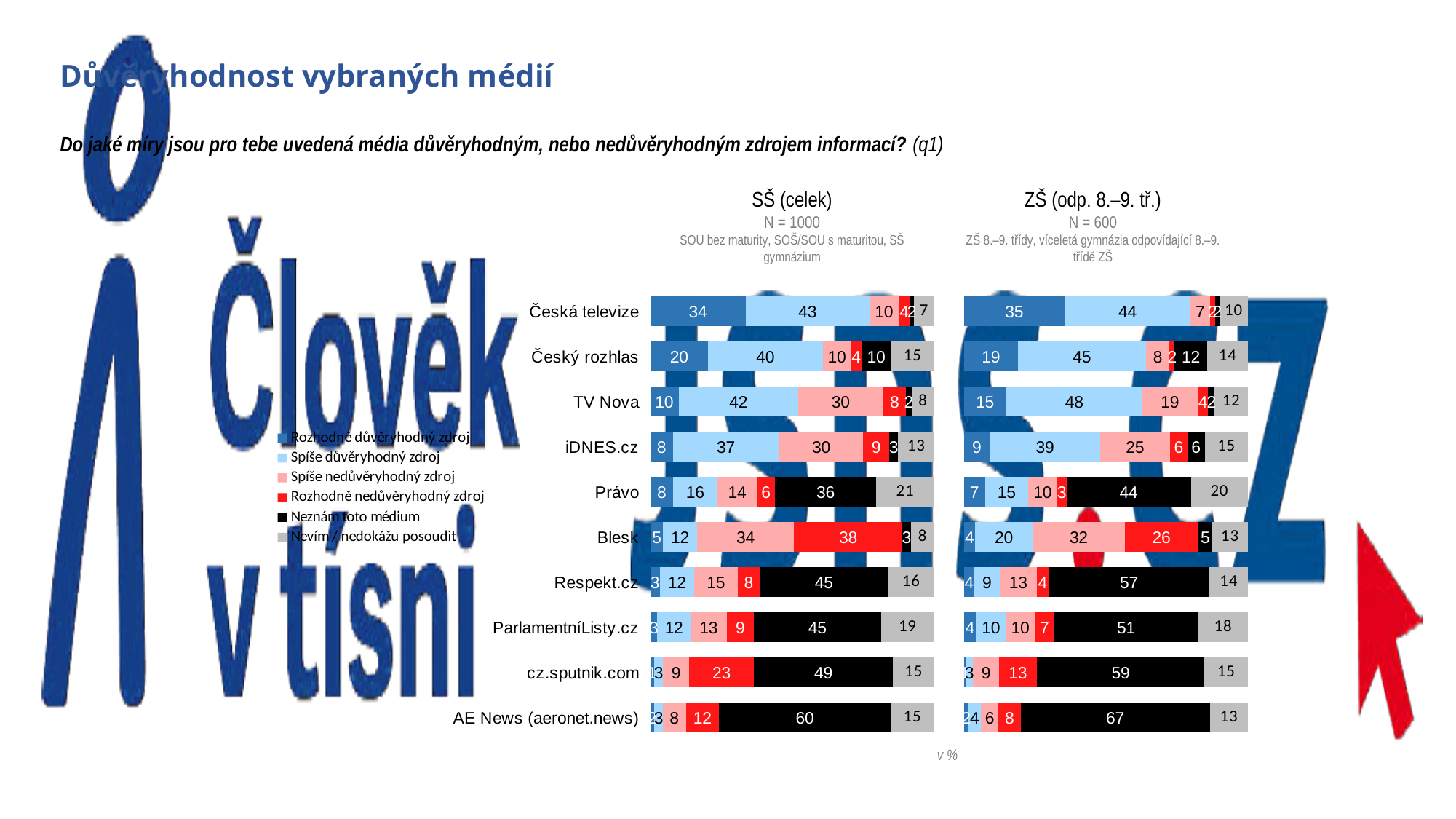
In the ZŠ (odp. 8.–9. tř.) chart, which is larger: the 'Neznám toto médium' value for Respekt.cz or for ParlamentníListy.cz? Respekt.cz In the ZŠ (odp. 8.–9. tř.) chart, which medium has the highest value for 'Rozhodně důvěryhodný zdroj'? Česká televize In the SŠ (celek) chart, what is the value of 'Rozhodně důvěryhodný zdroj' for Česká televize? 34 In the SŠ (celek) chart, what is the value of 'Rozhodně nedůvěryhodný zdroj' for Blesk? 38 What type of chart is the ZŠ (odp. 8.–9. tř.) chart? Stacked bar chart In the ZŠ (odp. 8.–9. tř.) chart, what is the value of 'Spíše důvěryhodný zdroj' for TV Nova? 48 What is the sample size (N) stated for the SŠ (celek) chart? N = 1000 How many media (categories) are shown in the SŠ (celek) chart? 10 In the SŠ (celek) chart, what is the difference between the 'Spíše důvěryhodný zdroj' values for Česká televize and Český rozhlas? 3 In the ZŠ (odp. 8.–9. tř.) chart, what is the value of 'Neznám toto médium' for AE News (aeronet.news)? 67 In the SŠ (celek) chart, which medium has the highest value for 'Neznám toto médium'? AE News (aeronet.news) How many series does the legend list? 6